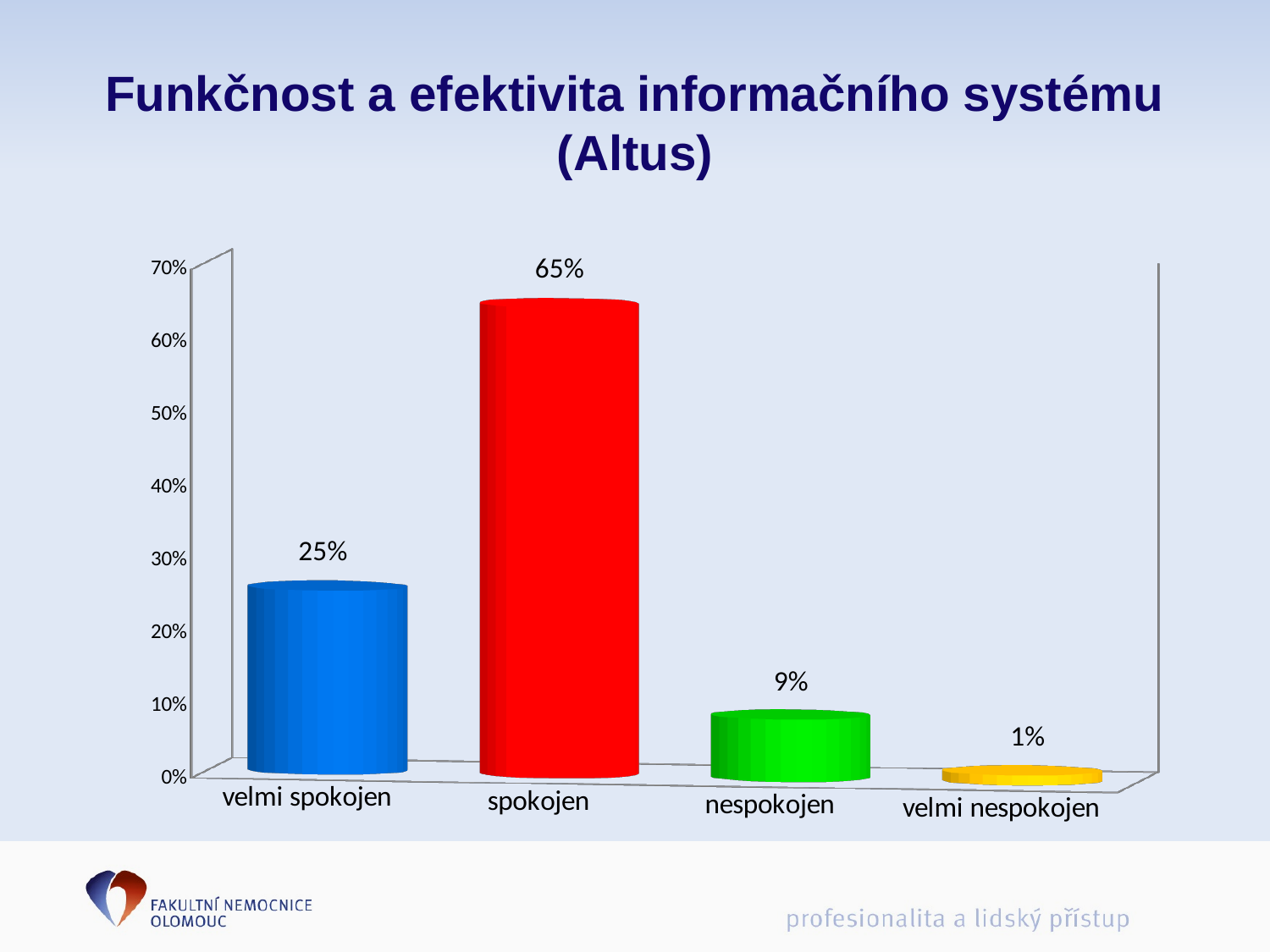
What colour is the bar for "spokojen"? red What is the difference between the values for "spokojen" and "velmi spokojen"? 40% What is the value for "velmi nespokojen"? 1% What is the value for "nespokojen"? 9% Which category has the highest value? spokojen What kind of chart is shown on the slide? bar chart What is the value for "velmi spokojen"? 25% Which is larger, the value for "velmi spokojen" or the value for "nespokojen"? velmi spokojen Is the value for "spokojen" greater or less than 60%? greater What is the value for "spokojen"? 65% Which category has the lowest value? velmi nespokojen How many categories are shown on the x axis? 4